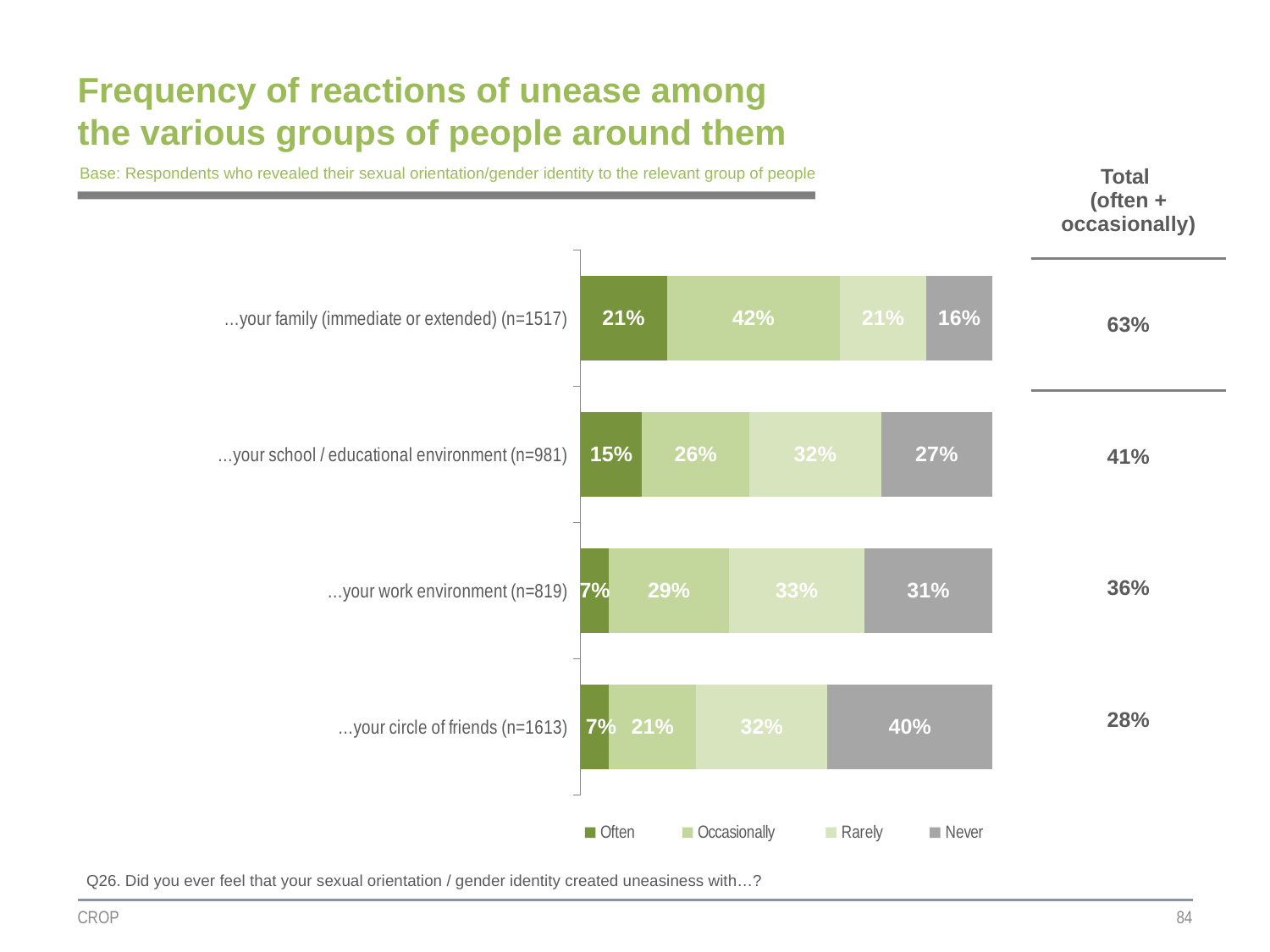
What is the 'Never' value for the work environment category? 31% How many categories (groups of people) are shown in the chart? 4 What is the difference between the 'Never' values for circle of friends and family? 24% What is the total (often + occasionally) shown for the family category? 63% Which is larger: the 'Often' value for school / educational environment or for work environment? school / educational environment Which category has the lowest 'Occasionally' value? …your circle of friends (n=1613) What kind of chart is shown on the slide? stacked bar chart What percentage of respondents said their family (immediate or extended) reacted with unease 'Often'? 21% How many series does the legend list? 4 What is the 'Rarely' value for the school / educational environment category? 32% What is the 'Occasionally' value for the circle of friends category? 21% Which category has the highest 'Never' value? …your circle of friends (n=1613)